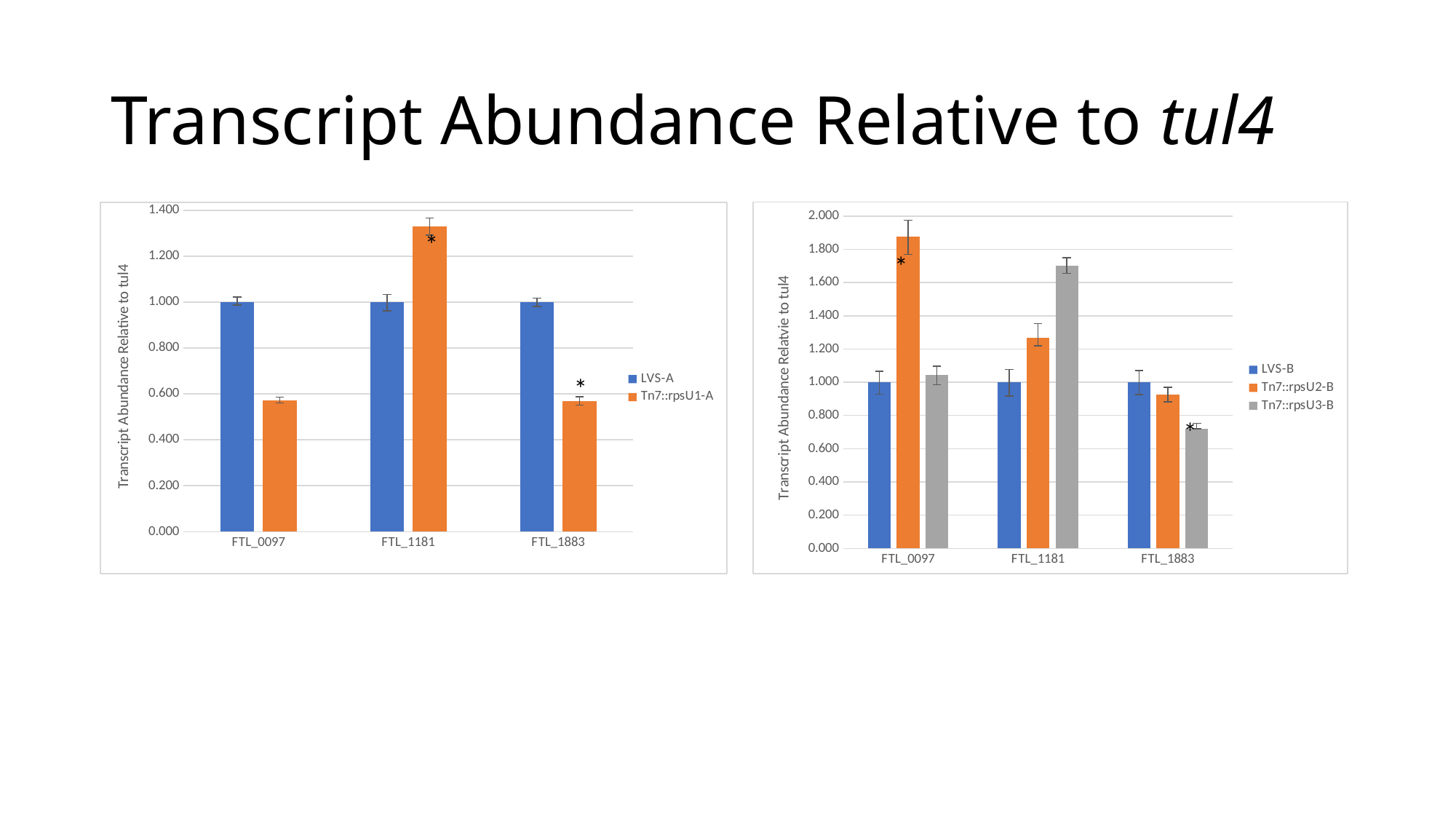
What kind of chart is the left chart on the slide? bar chart In the right chart, which series has the tallest bar for FTL_0097? Tn7::rpsU2-B How many series does the legend of the left chart list? 2 What are the legend entries of the right chart? LVS-B, Tn7::rpsU2-B, Tn7::rpsU3-B In the right chart, is the value of Tn7::rpsU3-B for FTL_1883 greater or less than 0.800? less In the left chart, is the value of Tn7::rpsU1-A for FTL_1181 greater or less than 1.200? greater In the right chart, what is the value of LVS-B for FTL_1181? 1.000 How many series does the legend of the right chart list? 3 In the left chart, what is the value of LVS-A for FTL_0097? 1.000 In the left chart, is the value of Tn7::rpsU1-A for FTL_0097 greater or less than 0.800? less In the right chart, for FTL_1181, which is larger: Tn7::rpsU2-B or Tn7::rpsU3-B? Tn7::rpsU3-B How many categories are shown on the x axis of the left chart? 3